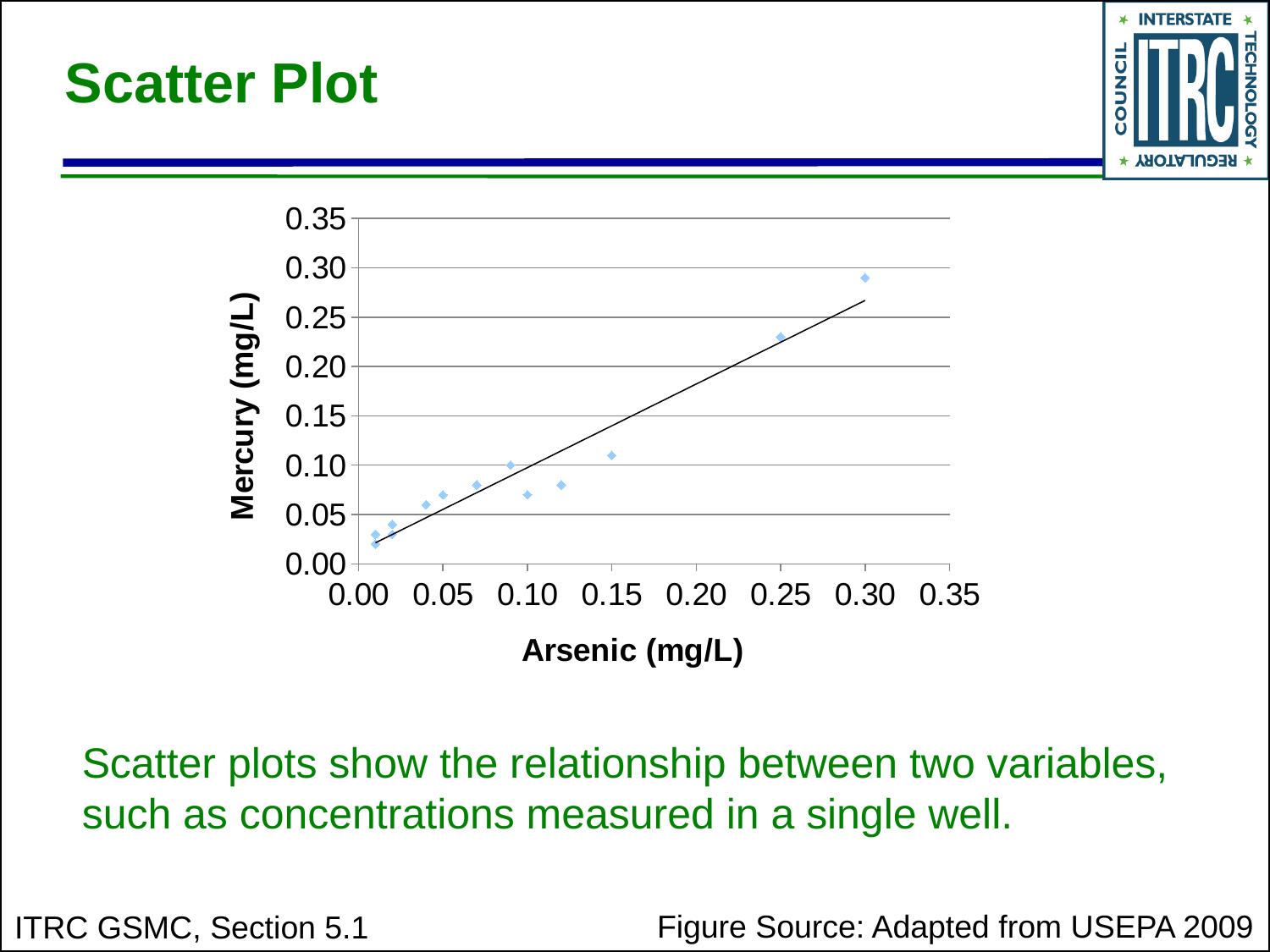
What kind of chart is shown on the slide? Scatter plot What is the highest value shown on the y axis? 0.35 Which point has the larger mercury value: the one at arsenic 0.25 or the one at arsenic 0.30? The one at arsenic 0.30 What is the label of the y axis? Mercury (mg/L) Is the mercury value for the point at arsenic 0.15 greater or less than 0.15? less Is the mercury value for the point at arsenic 0.10 greater or less than 0.10? less Is the mercury value for the point at arsenic 0.30 greater or less than 0.25? greater Do the mercury values generally rise or fall as arsenic increases along the x axis? Rise At which arsenic value is the highest mercury value plotted? 0.30 Which point has the larger mercury value: the one at arsenic 0.15 or the one at arsenic 0.25? The one at arsenic 0.25 What is the label of the x axis? Arsenic (mg/L)